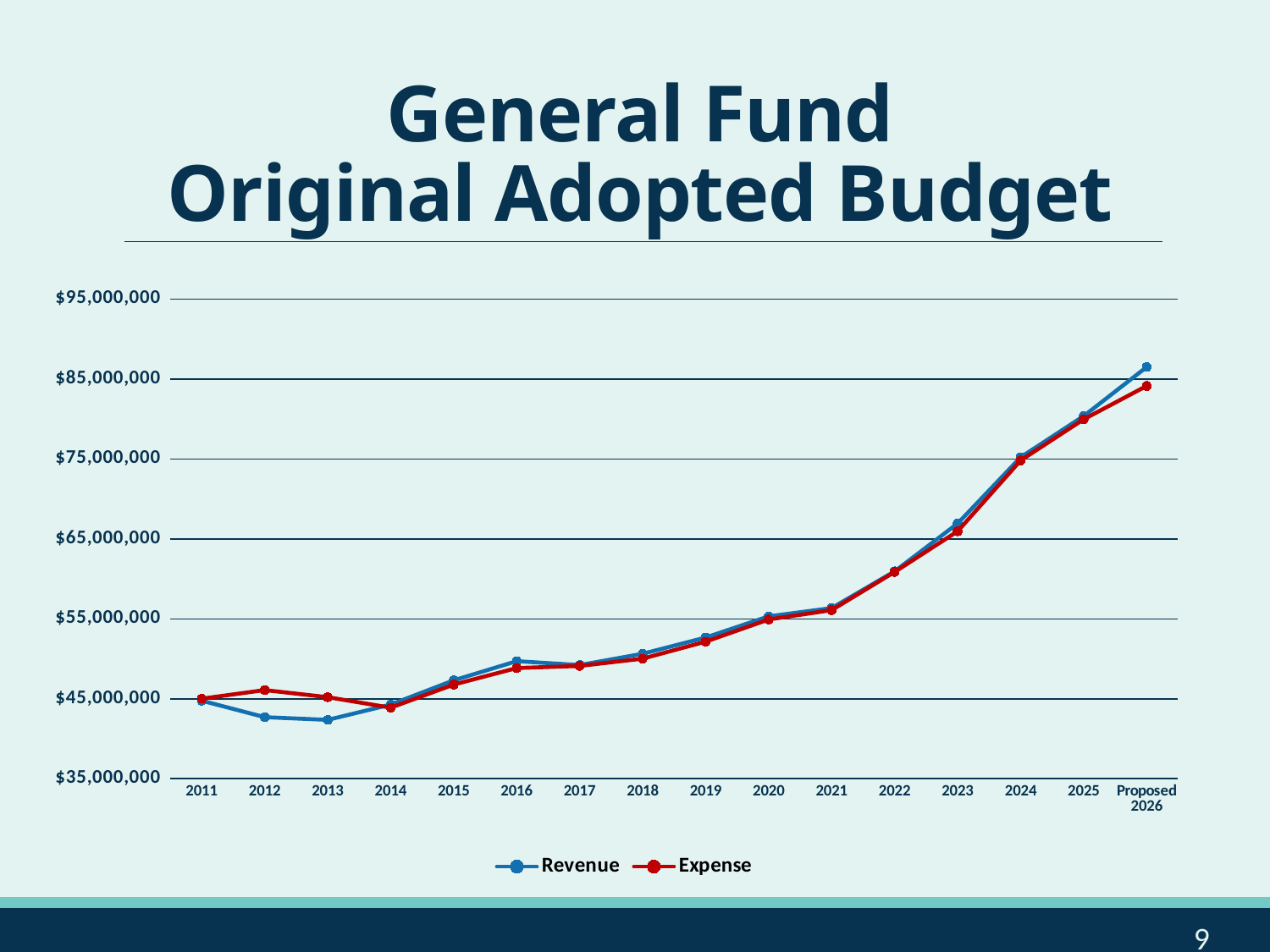
What kind of chart is shown on the slide? line chart Is the Expense value for Proposed 2026 greater or less than $85,000,000? less Is the Revenue value for 2023 greater or less than $65,000,000? greater In Proposed 2026, which is larger, Revenue or Expense? Revenue In which year is Expense lowest? 2014 In which year is Revenue highest? Proposed 2026 How many series does the legend list? 2 Do the Revenue values generally rise or fall from 2014 to Proposed 2026? rise In 2012, which is larger, Revenue or Expense? Expense Is the Revenue value for Proposed 2026 greater or less than $85,000,000? greater How many years (points) are plotted along the x axis? 16